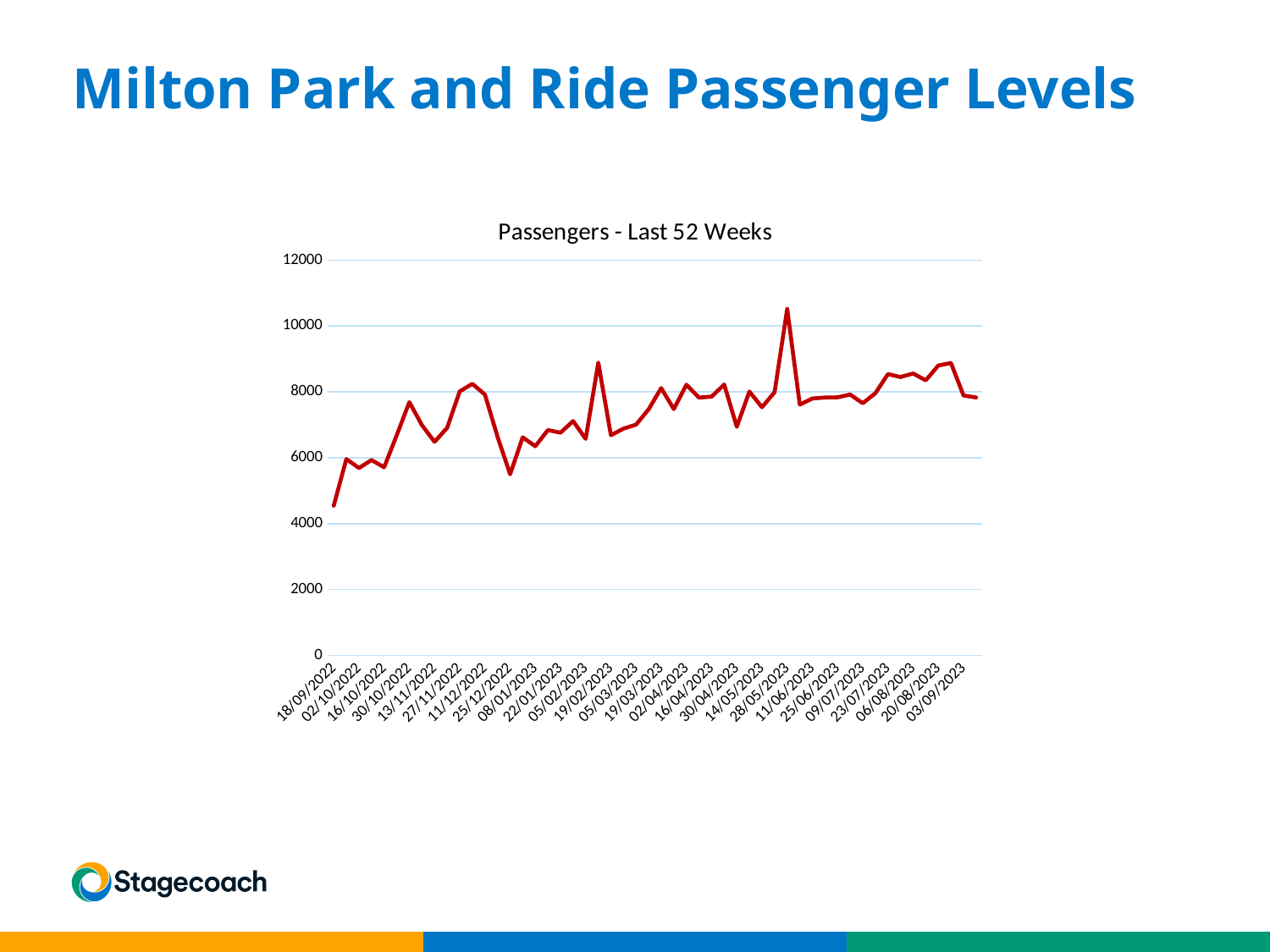
Is the highest point on the line greater or less than 10000? greater Is the value for 25/12/2022 greater or less than 6000? less How many weeks of data does the chart title say it covers? 52 Which date has the lowest passenger value on the chart? 18/09/2022 Which is larger, the value for 18/09/2022 or the value for 03/09/2023? 03/09/2023 What is the title of the chart? Passengers - Last 52 Weeks What kind of chart is shown on the slide? Line chart Is the value for 18/09/2022 greater or less than 4000? greater What colour is the line plotted on the chart? Red Overall, do passenger levels rise or fall from the start to the end of the period shown? rise